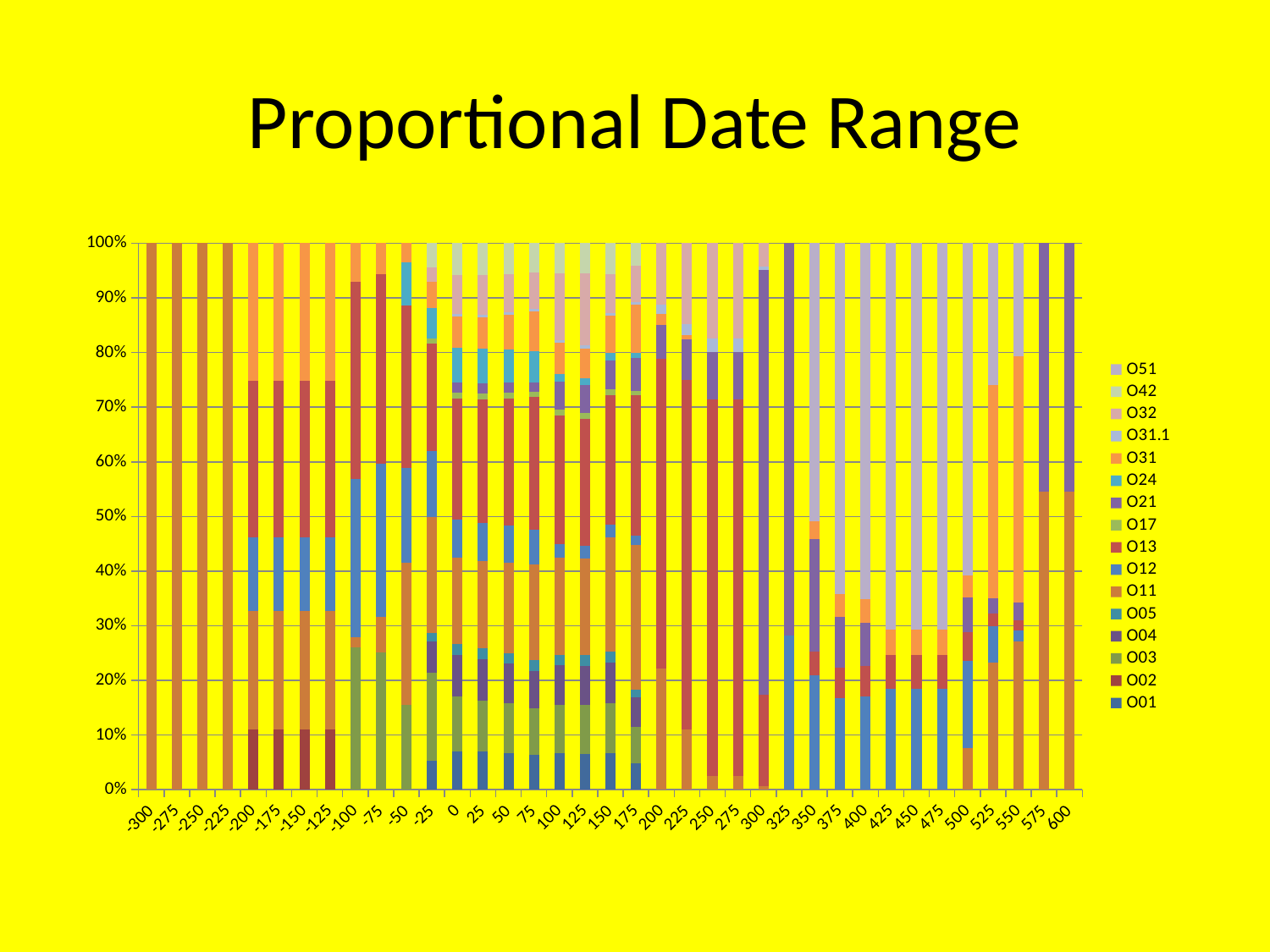
What is the total height of the stacked bar for 0? 100% What is the first category on the x axis? -300 Is the value for O11 at 575 greater or less than 40%? greater How many series does the legend list? 16 What kind of chart is shown on the slide? Stacked bar chart Is the value for O12 at -200 greater or less than 20%? less Is the value for O31 at -200 greater or less than 20%? greater What is the title of the chart? Proportional Date Range How many date categories are shown along the x axis? 37